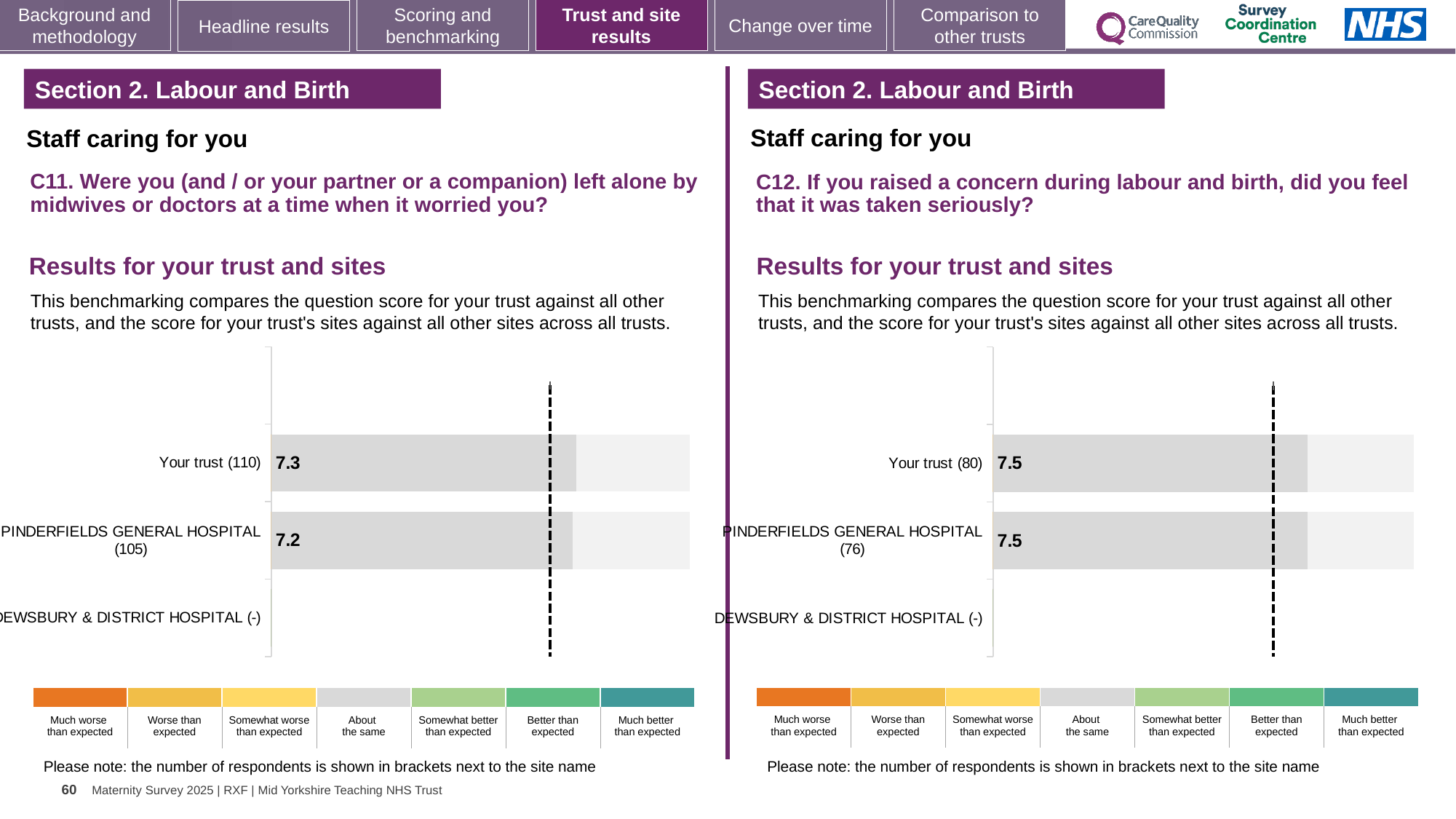
On the C12 chart (right), how many respondents are shown in brackets for Pinderfields General Hospital? 76 On the C11 chart (left), what is the difference between the score for Your trust and the score for Pinderfields General Hospital? 0.1 What type of chart is used on the C11 chart (left)? Bar chart On the C12 chart (right), what is the score for Pinderfields General Hospital (76)? 7.5 On the C12 chart (right), what is the difference between the score for Your trust and the score for Pinderfields General Hospital? 0 On the C11 chart (left), what is the score for Pinderfields General Hospital (105)? 7.2 How many categories (rows) are listed on the C11 chart (left)? 3 On the C11 chart (left), what is the score for Your trust (110)? 7.3 How many categories (rows) are listed on the C12 chart (right)? 3 On the C12 chart (right), what is the score for Your trust (80)? 7.5 On the C11 chart (left), which has the higher score, Your trust or Pinderfields General Hospital? Your trust On the C11 chart (left), how many respondents are shown in brackets for Your trust? 110